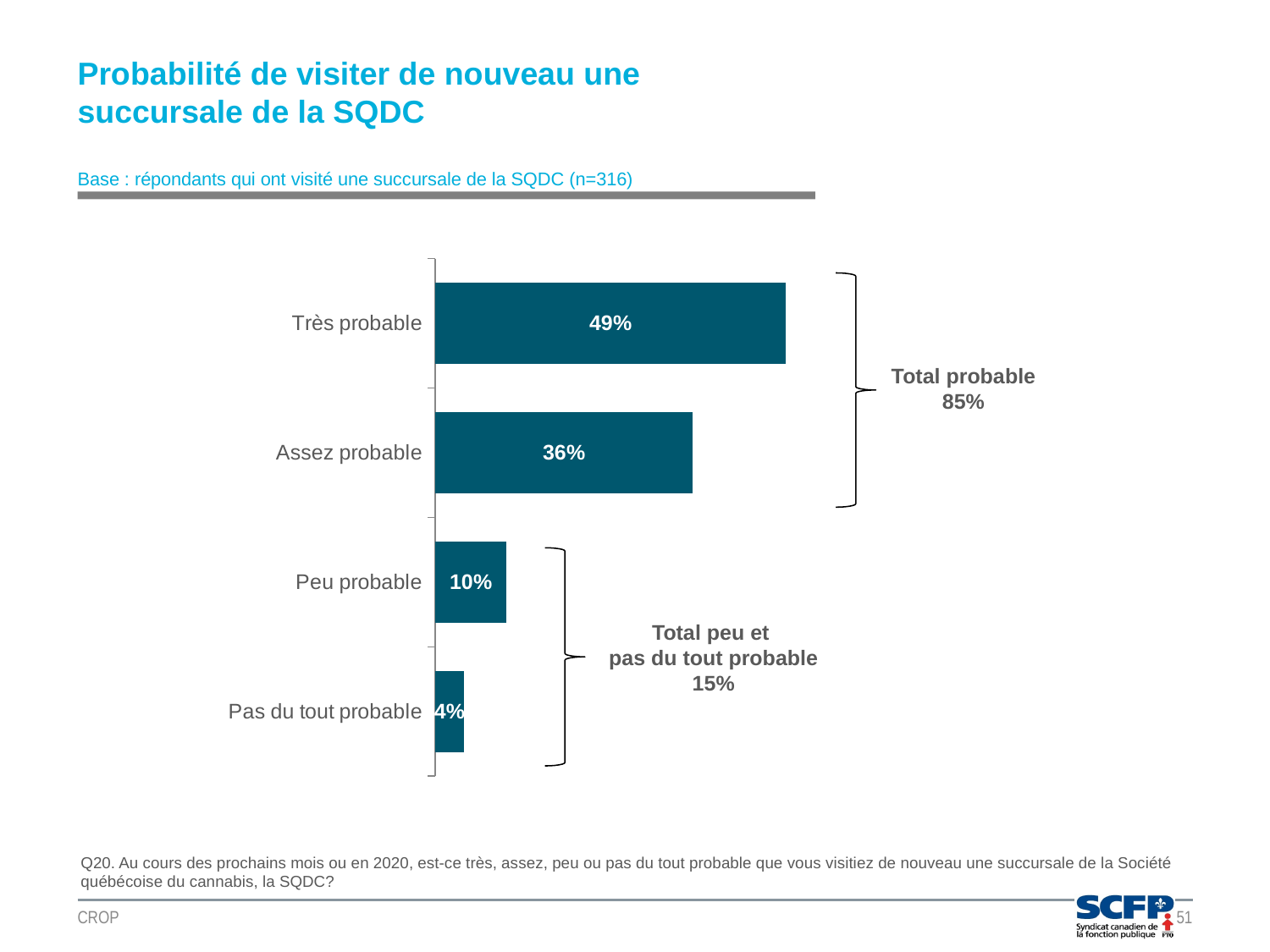
What kind of chart is shown on the slide? Bar chart What is the value for "Pas du tout probable"? 4% Which category has the lowest value? Pas du tout probable How many categories are shown in the chart? 4 What is the "Total peu et pas du tout probable" value shown next to the bracket? 15% What is the "Total probable" value shown next to the bracket? 85% What is the difference between the values for "Très probable" and "Assez probable"? 13% What is the value for "Peu probable"? 10% What is the value for "Assez probable"? 36% Which is larger, the value for "Peu probable" or the value for "Pas du tout probable"? Peu probable Which category has the highest value? Très probable What is the value for "Très probable"? 49%